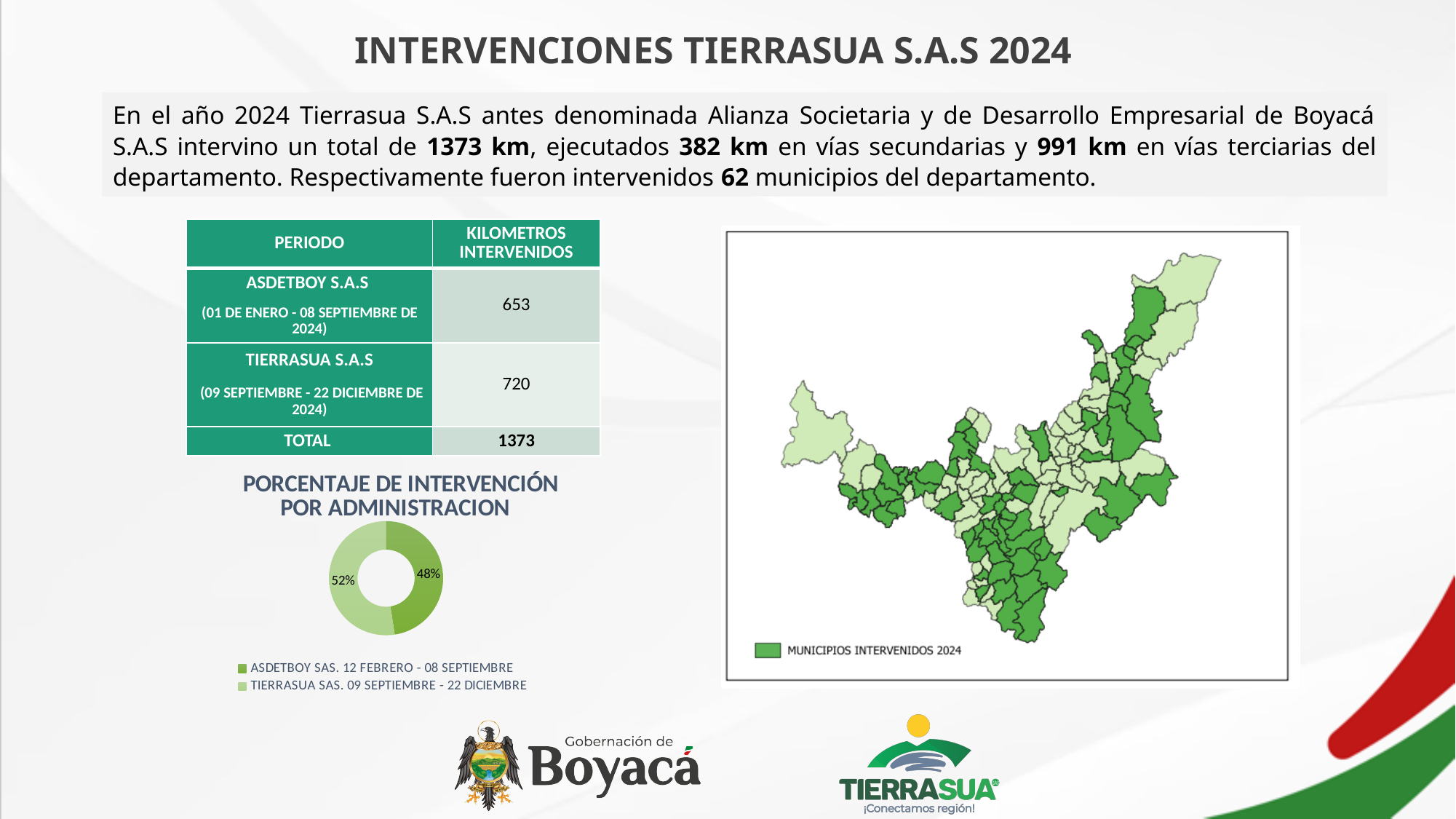
In the 'PORCENTAJE DE INTERVENCIÓN POR ADMINISTRACION' chart, what is the difference in percentage points between the TIERRASUA SAS share and the ASDETBOY SAS share? 4 percentage points In the 'PORCENTAJE DE INTERVENCIÓN POR ADMINISTRACION' chart, which administration has the smaller share? ASDETBOY SAS. 12 FEBRERO - 08 SEPTIEMBRE In the 'PORCENTAJE DE INTERVENCIÓN POR ADMINISTRACION' chart, which legend entry is shown in the darker green colour? ASDETBOY SAS. 12 FEBRERO - 08 SEPTIEMBRE How many slices does the 'PORCENTAJE DE INTERVENCIÓN POR ADMINISTRACION' chart have? 2 What kind of chart is shown under the title 'PORCENTAJE DE INTERVENCIÓN POR ADMINISTRACION'? Pie (donut) chart In the 'PORCENTAJE DE INTERVENCIÓN POR ADMINISTRACION' chart, what share is shown for ASDETBOY SAS (12 Febrero - 08 Septiembre)? 48% In the 'PORCENTAJE DE INTERVENCIÓN POR ADMINISTRACION' chart, what share is shown for TIERRASUA SAS (09 Septiembre - 22 Diciembre)? 52% How many entries does the legend of the 'PORCENTAJE DE INTERVENCIÓN POR ADMINISTRACION' chart list? 2 In the 'PORCENTAJE DE INTERVENCIÓN POR ADMINISTRACION' chart, is the share for TIERRASUA SAS greater or less than 50%? greater What is the title of the donut chart on the slide? PORCENTAJE DE INTERVENCIÓN POR ADMINISTRACION In the 'PORCENTAJE DE INTERVENCIÓN POR ADMINISTRACION' chart, which administration has the larger share? TIERRASUA SAS. 09 SEPTIEMBRE - 22 DICIEMBRE In the 'PORCENTAJE DE INTERVENCIÓN POR ADMINISTRACION' chart, is the share for ASDETBOY SAS larger or smaller than the share for TIERRASUA SAS? Smaller